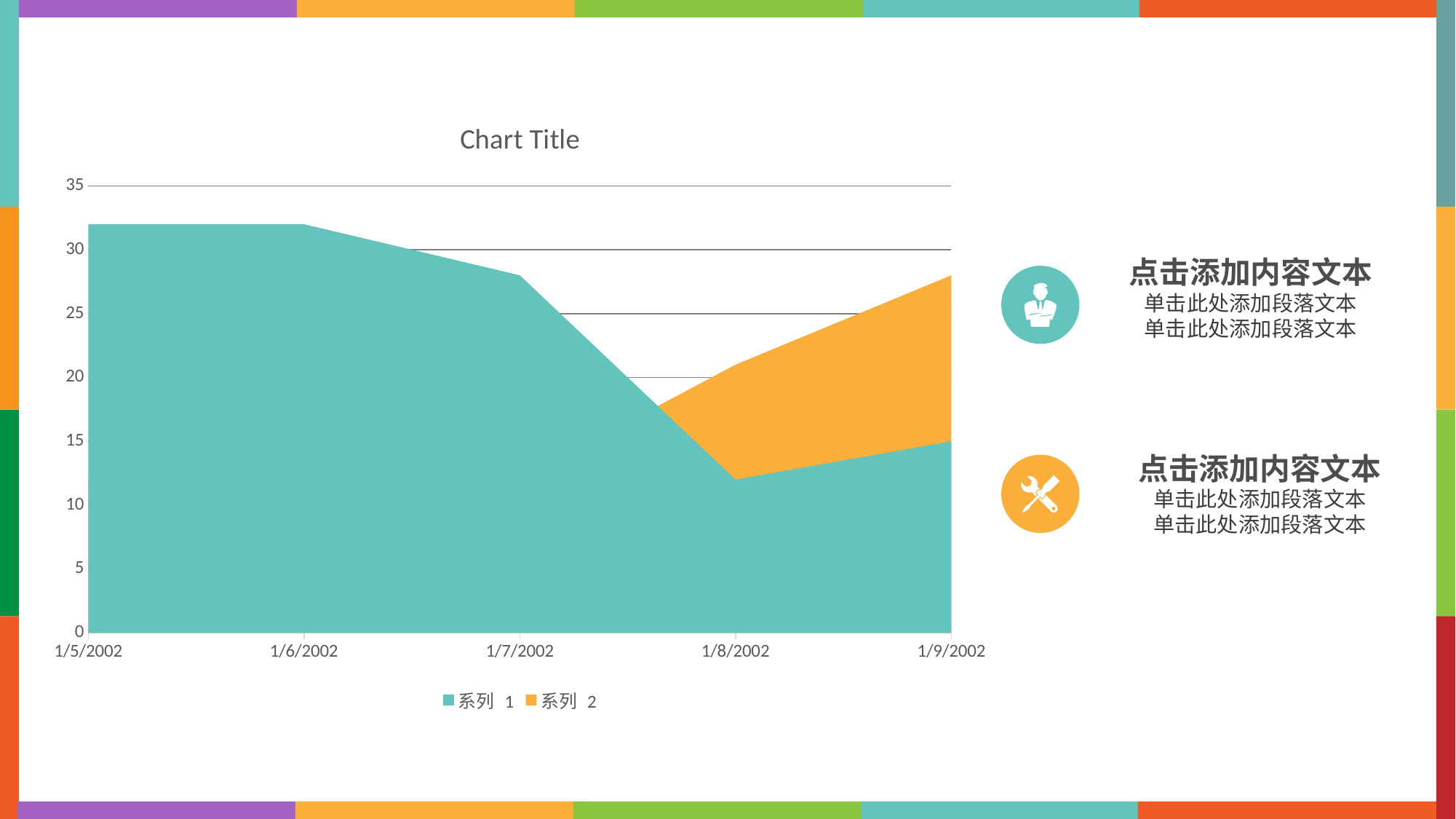
Which series is shown in orange in the legend? 系列 2 At which date is 系列 1 lowest? 1/8/2002 Is the value for 系列 1 at 1/7/2002 greater or less than 25? greater Is the value for 系列 1 at 1/5/2002 greater or less than 30? greater How many series does the legend list? 2 Is the value for 系列 1 at 1/8/2002 greater or less than 15? less Does 系列 1 rise or fall from 1/6/2002 to 1/8/2002? fall What kind of chart is shown on the slide? area chart What is the title of the chart? Chart Title Which is larger for 系列 1: the value at 1/5/2002 or at 1/8/2002? 1/5/2002 How many dates are shown on the x axis? 5